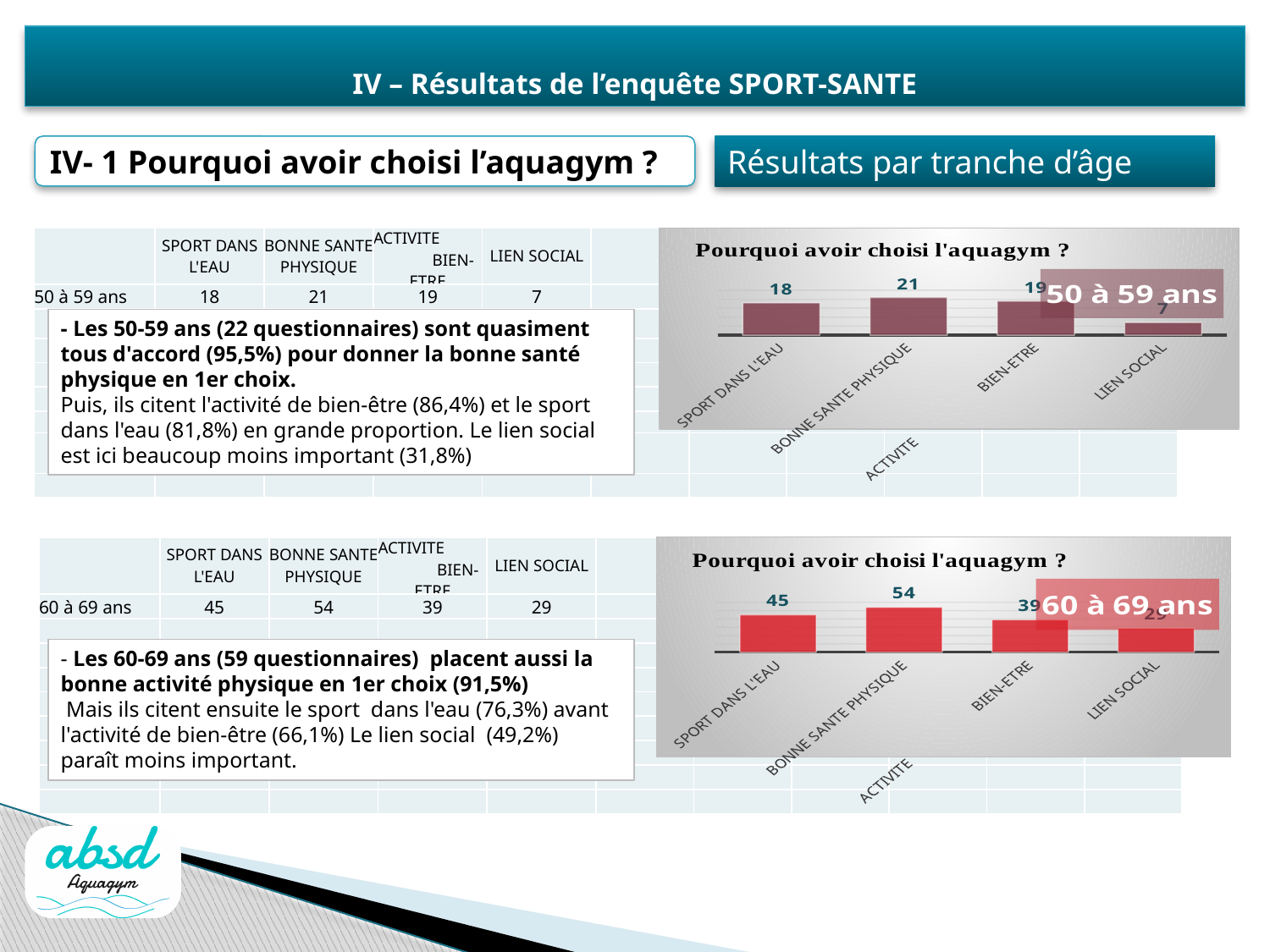
In the top chart (50 à 59 ans), what is the difference between SPORT DANS L'EAU and LIEN SOCIAL? 11 In the top chart (50 à 59 ans), which category has the highest value? BONNE SANTE PHYSIQUE In the top chart (50 à 59 ans), what is the value for BONNE SANTE PHYSIQUE? 21 In the bottom chart (60 à 69 ans), which is larger: SPORT DANS L'EAU or ACTIVITE BIEN-ETRE? SPORT DANS L'EAU In the bottom chart (60 à 69 ans), what is the value for ACTIVITE BIEN-ETRE? 39 In the bottom chart (60 à 69 ans), which category has the lowest value? LIEN SOCIAL What is the title of the top chart? Pourquoi avoir choisi l'aquagym ? What type of chart is the bottom chart (60 à 69 ans)? Bar chart In the top chart (50 à 59 ans), what is the value for LIEN SOCIAL? 7 How many categories are shown in the top chart (50 à 59 ans)? 4 In the bottom chart (60 à 69 ans), what is the difference between BONNE SANTE PHYSIQUE and LIEN SOCIAL? 25 In the bottom chart (60 à 69 ans), what is the value for SPORT DANS L'EAU? 45